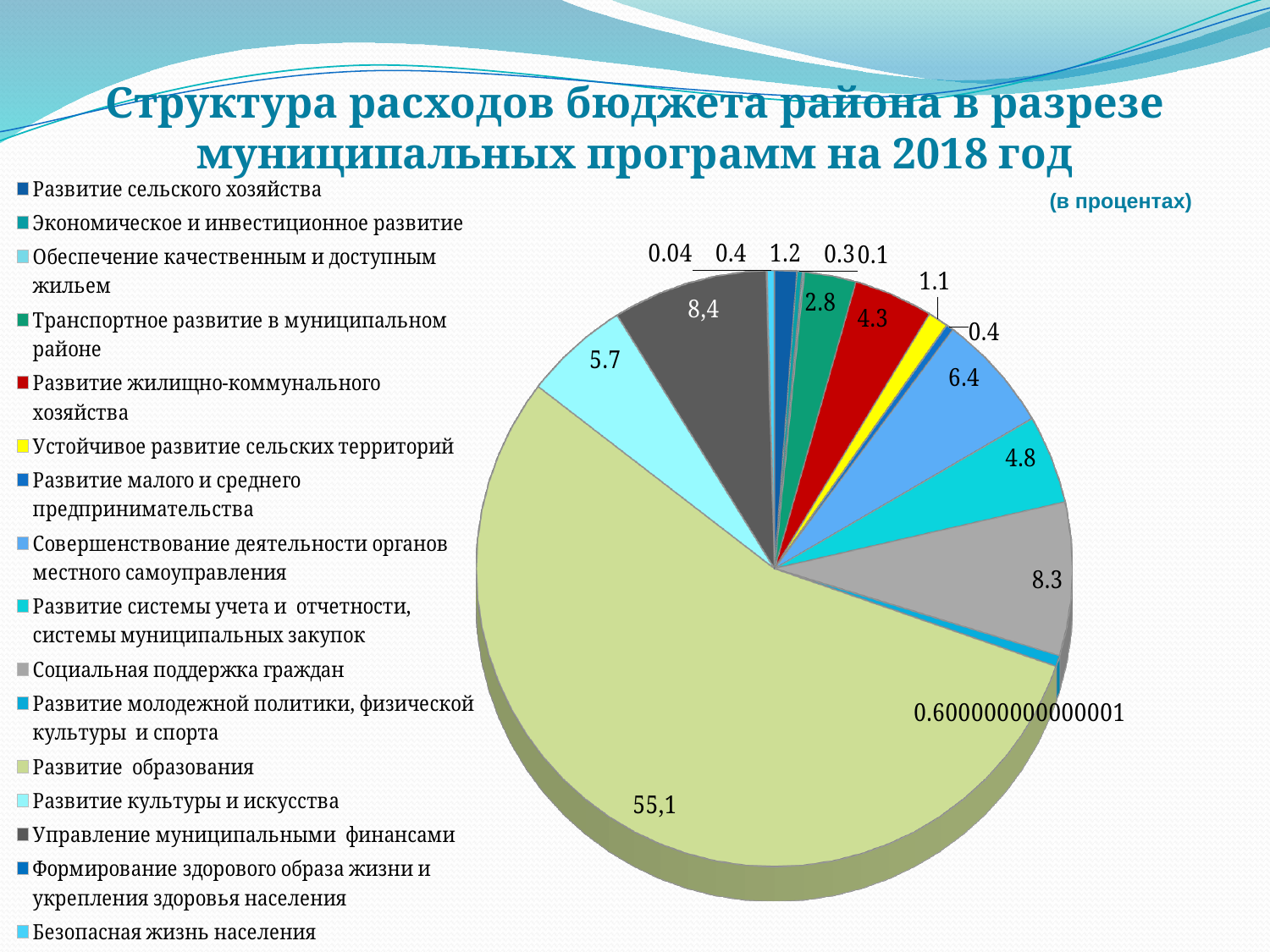
What is the value shown for Социальная поддержка граждан? 8.3 What is the value shown for Развитие культуры и искусства? 5.7 What is the difference between the value for Совершенствование деятельности органов местного самоуправления and the value for Развитие системы учета и отчетности, системы муниципальных закупок? 1.6 Which is larger, the value for Социальная поддержка граждан or the value for Развитие культуры и искусства? Социальная поддержка граждан What is the title of the chart? Структура расходов бюджета района в разрезе муниципальных программ на 2018 год What kind of chart is shown on the slide? pie chart What is the value shown for Совершенствование деятельности органов местного самоуправления? 6.4 What is the value shown for Развитие жилищно-коммунального хозяйства? 4.3 Which category has the largest slice of the pie? Развитие образования What is the value shown for Управление муниципальными финансами? 8,4 What is the value shown for Развитие образования? 55,1 How many categories does the legend list? 16